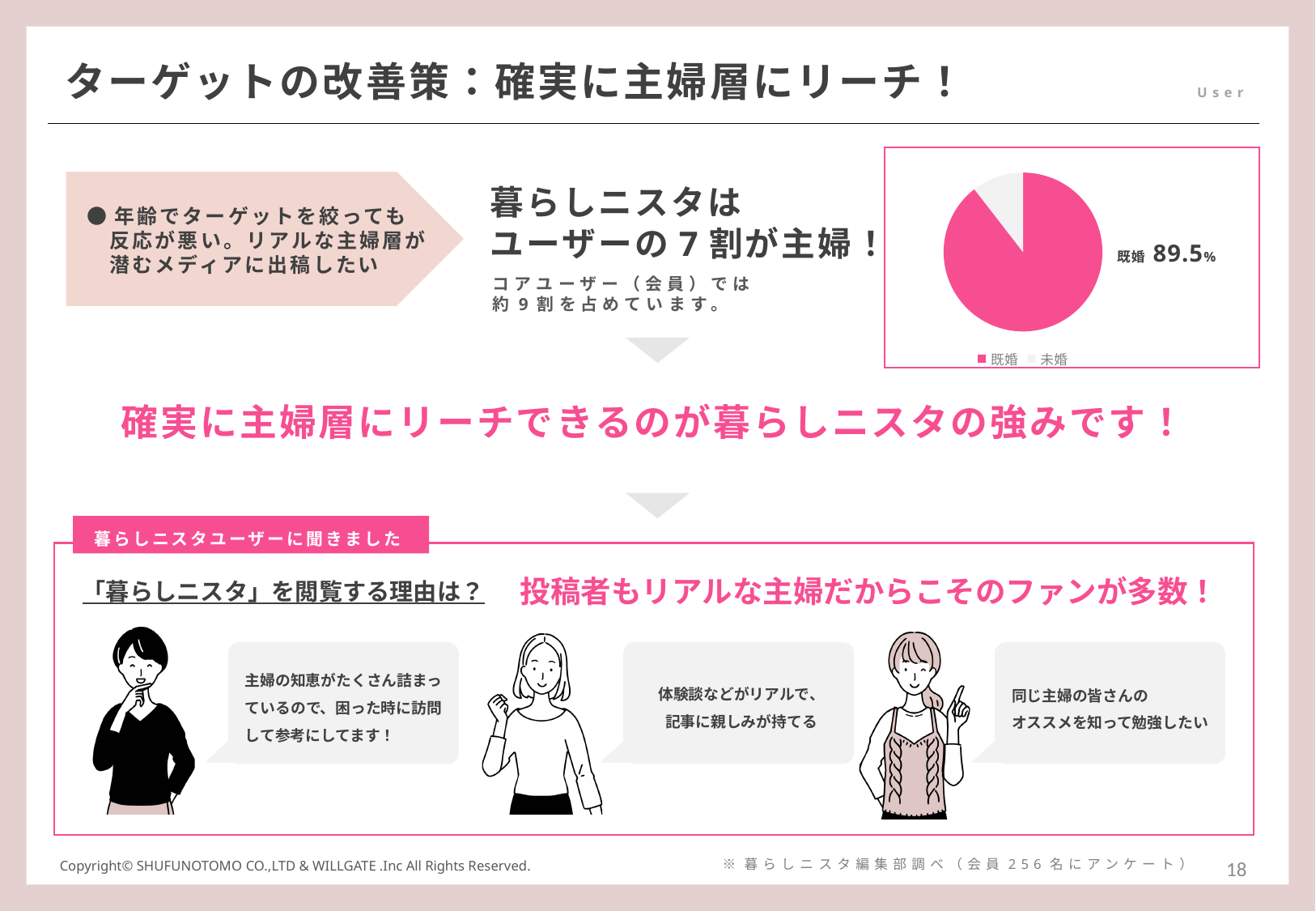
How many entries does the pie chart's legend list? 2 Which slice is larger in the pie chart, 既婚 or 未婚? 既婚 Which category has the smallest slice in the pie chart? 未婚 What share of the pie does the 既婚 slice represent? 89.5% What kind of chart is shown on the slide? pie chart What are the two legend entries of the pie chart? 既婚 and 未婚 How many slices does the pie chart have? 2 What percentage of the pie chart is labelled 既婚? 89.5% What colour is the 既婚 slice in the pie chart? pink Which category has the largest slice in the pie chart? 既婚